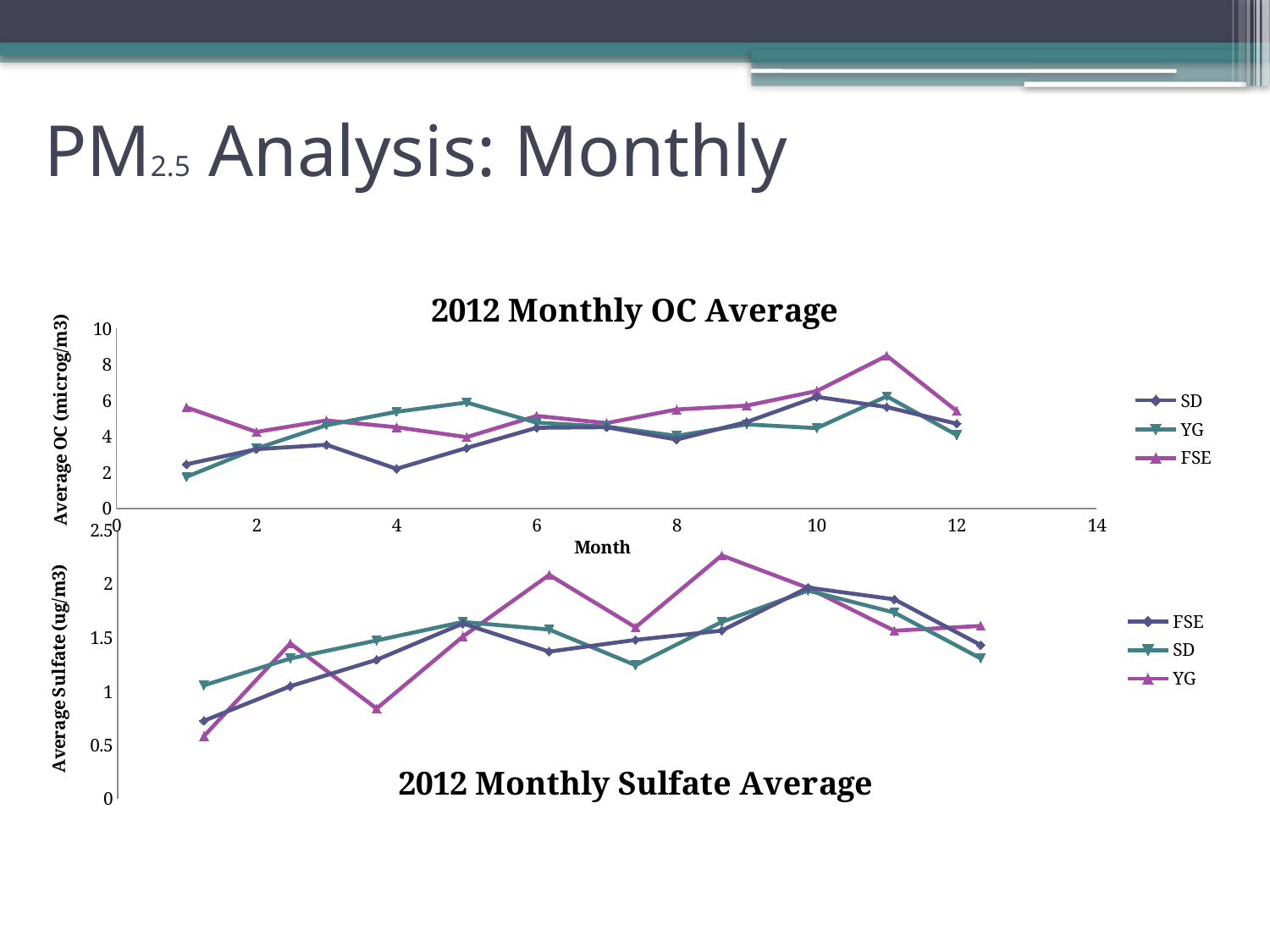
How many monthly data points does each series in the "2012 Monthly OC Average" chart have? 12 How many series does the legend of the "2012 Monthly Sulfate Average" chart list? 3 In the "2012 Monthly OC Average" chart, which series has the larger value at month 1, FSE or YG? FSE In the "2012 Monthly OC Average" chart, which series has the highest value at month 11? FSE In the "2012 Monthly OC Average" chart, is the SD value at month 4 greater or less than 4? less In the "2012 Monthly Sulfate Average" chart, is the YG value at month 1 greater or less than 1? less What kind of chart is the "2012 Monthly OC Average" chart? Line chart In the "2012 Monthly Sulfate Average" chart, which series has the larger value at month 4, SD or YG? SD In the "2012 Monthly OC Average" chart, is the FSE value at month 11 greater or less than 8? greater How many series does the legend of the "2012 Monthly OC Average" chart list? 3